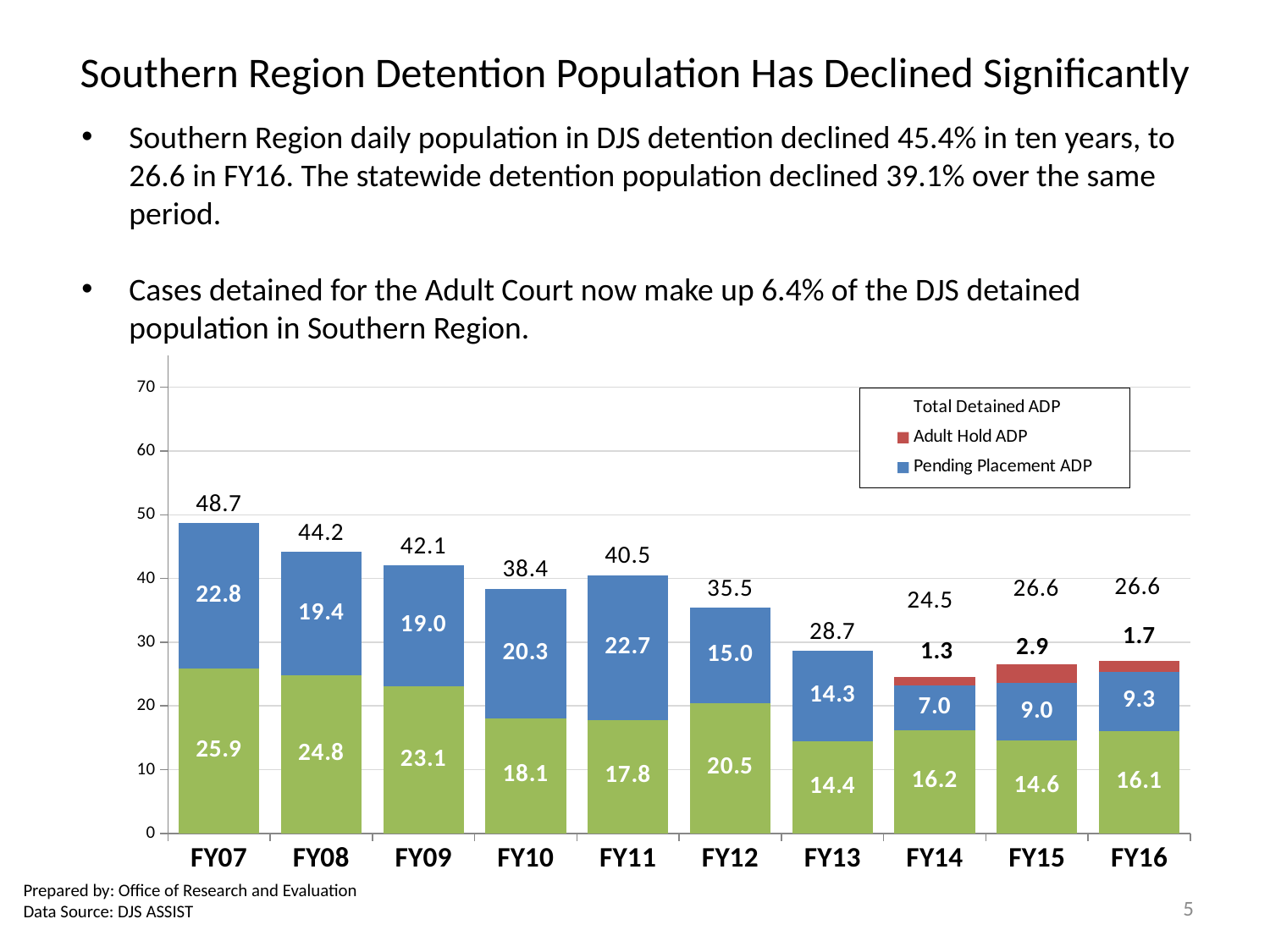
How many fiscal years are shown on the x axis? 10 What is the Pending Placement ADP value for FY11? 22.7 What is the Total Detained ADP for FY07? 48.7 Does the Total Detained ADP generally rise or fall from FY07 to FY16? Fall What is the Adult Hold ADP value for FY15? 2.9 What kind of chart is shown on the slide? Stacked bar chart Which fiscal year has the lowest Total Detained ADP? FY14 Which fiscal year has the highest Total Detained ADP? FY07 What value is printed in the green segment of the FY12 bar? 20.5 Which is larger, the Pending Placement ADP in FY10 or in FY12? FY10 What is the difference between the Total Detained ADP in FY07 and in FY16? 22.1 How many entries does the legend list? 3